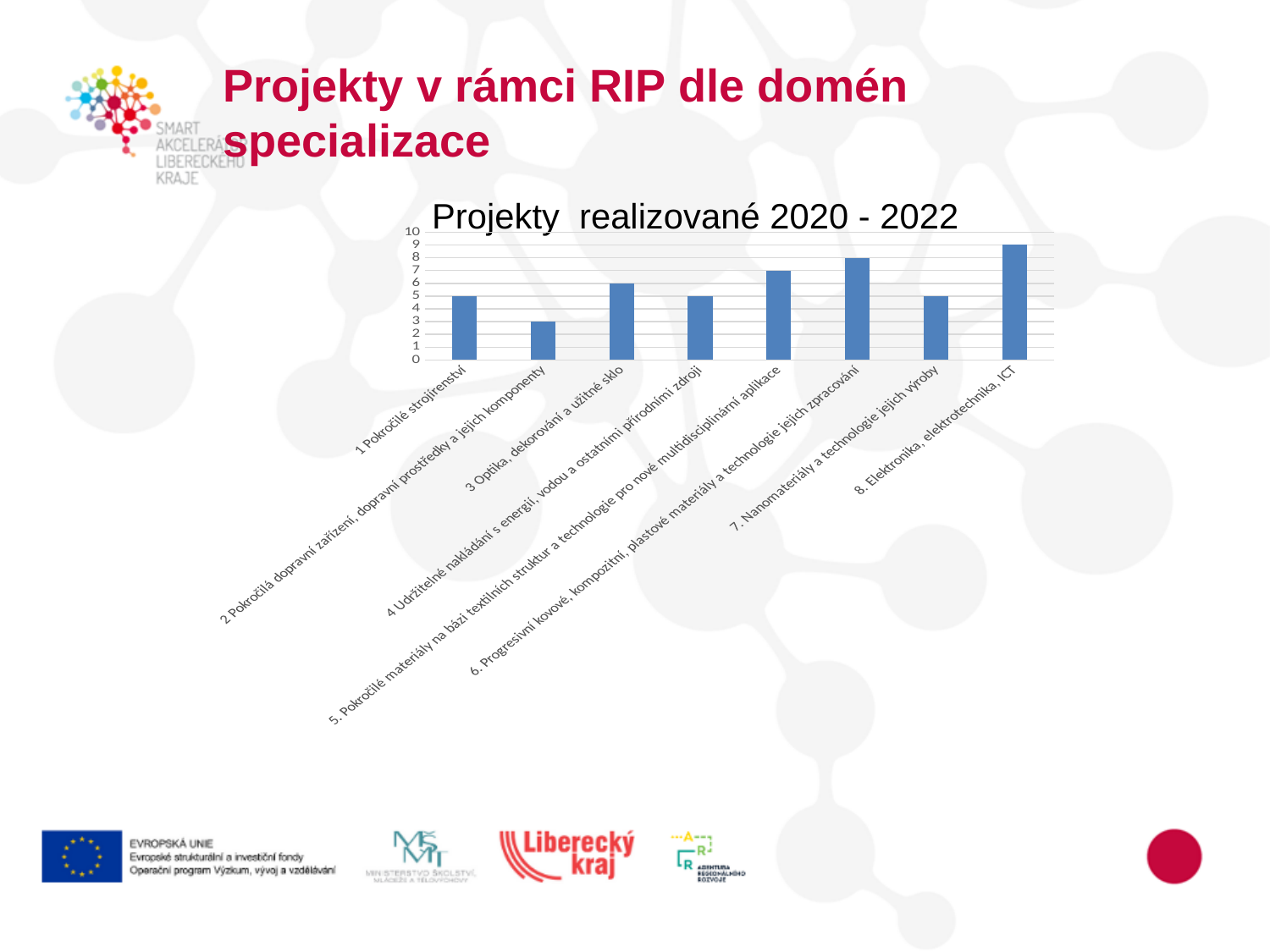
How many projects are shown for '1 Pokročilé strojírenství'? 5 How many categories (domains) are shown on the x axis of the chart? 8 Which domain has the highest number of projects? 8. Elektronika, elektrotechnika, ICT How many projects are shown for '8. Elektronika, elektrotechnika, ICT'? 9 Is the value for '7. Nanomateriály a technologie jejich výroby' greater or less than 6? less What kind of chart is shown on the slide? bar chart Which has more projects: '3 Optika, dekorování a užitné sklo' or '2 Pokročilá dopravní zařízení, dopravní prostředky a jejich komponenty'? 3 Optika, dekorování a užitné sklo How many projects are shown for '2 Pokročilá dopravní zařízení, dopravní prostředky a jejich komponenty'? 3 What is the title of the chart? Projekty realizované 2020 - 2022 What is the highest value shown on the vertical axis of the chart? 10 Which domain has the lowest number of projects? 2 Pokročilá dopravní zařízení, dopravní prostředky a jejich komponenty Is the value for '6. Progresivní kovové, kompozitní, plastové materiály a technologie jejich zpracování' greater or less than 6? greater